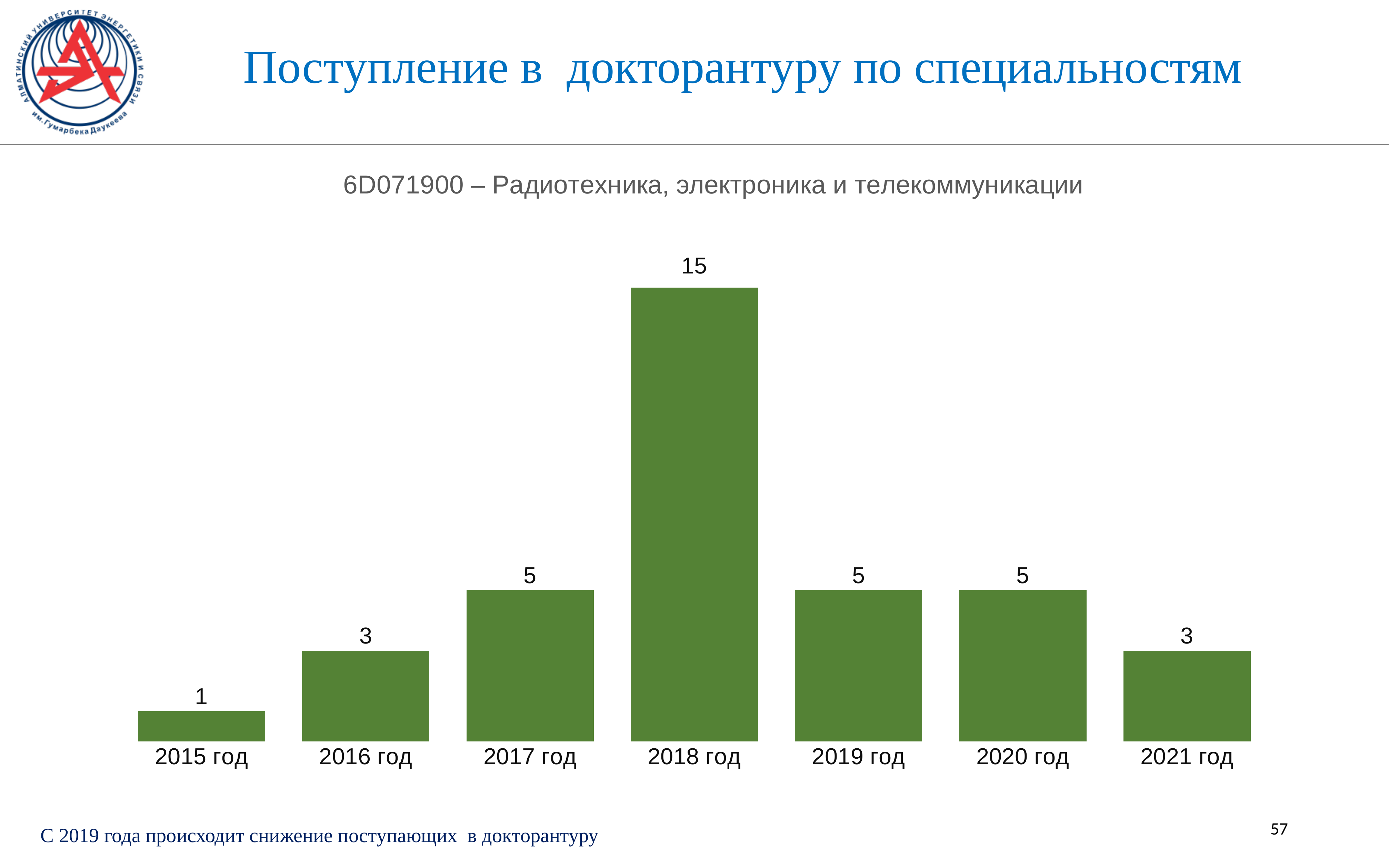
What is the value for 2018 год? 15 What is the value for 2017 год? 5 How many years are shown on the chart? 7 Which year has the lowest value? 2015 год What is the difference between the values for 2018 год and 2019 год? 10 What is the value for 2015 год? 1 What is the value for 2021 год? 3 What is the difference between the values for 2016 год and 2015 год? 2 What kind of chart is shown on the slide? bar chart Which year has the highest value? 2018 год Which is larger, the value for 2020 год or the value for 2021 год? 2020 год Do the values rise or fall from 2018 год to 2021 год? fall